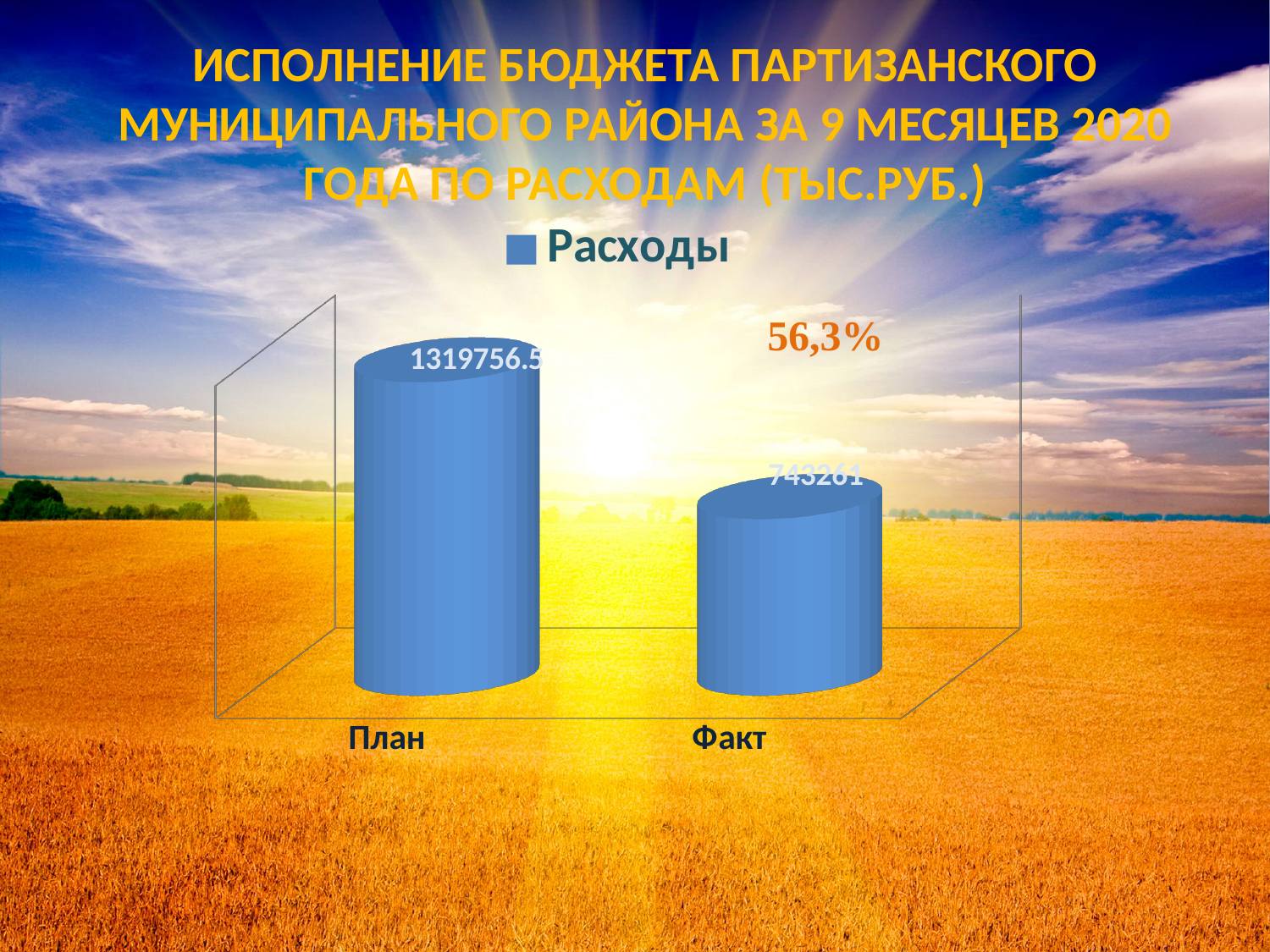
Which category has the highest value? План Which is larger, the value for План or the value for Факт? План How many categories are shown on the x axis? 2 What percentage is printed above the Факт bar? 56,3% What is the value for Факт? 743261 How many series does the legend list? 1 What is the value for План? 1319756.5 Do the values rise or fall from План to Факт? fall What kind of chart is shown on the slide? bar chart What is the name of the series in the legend? Расходы Which category has the lowest value? Факт What is the difference between the value for План and the value for Факт? 576495.5